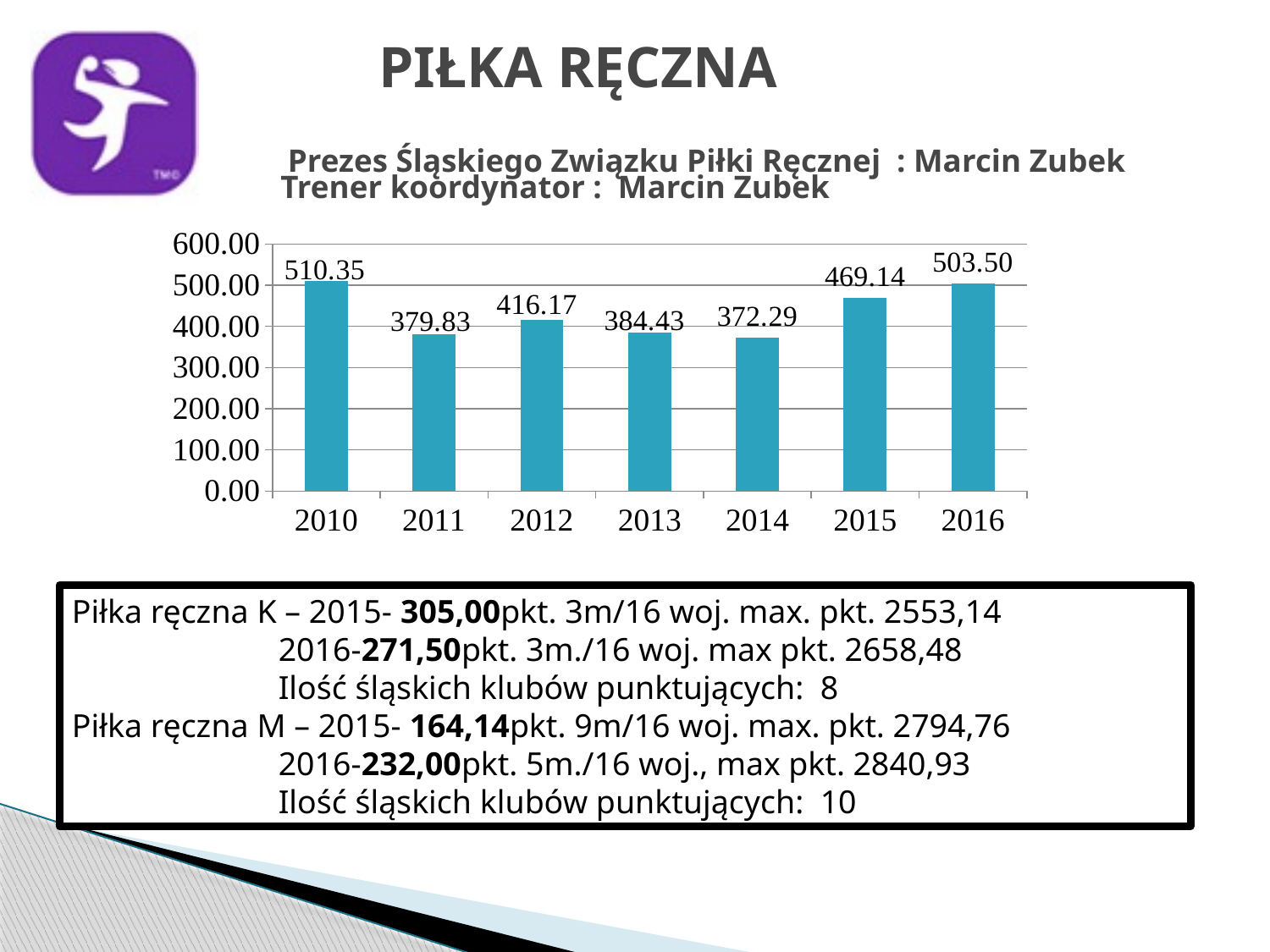
What is the value for 2013? 384.43 Which is larger, the value for 2012 or the value for 2013? 2012 Which year has the lowest value? 2014 Do the values rise or fall from 2014 to 2016? rise Which year has the highest value? 2010 What is the difference between the values for 2015 and 2014? 96.85 Is the value for 2015 greater or less than 400.00? greater How many years are shown on the x axis? 7 What is the value for 2016? 503.50 What is the difference between the values for 2012 and 2011? 36.34 What kind of chart is shown on the slide? bar chart What is the value for 2010? 510.35